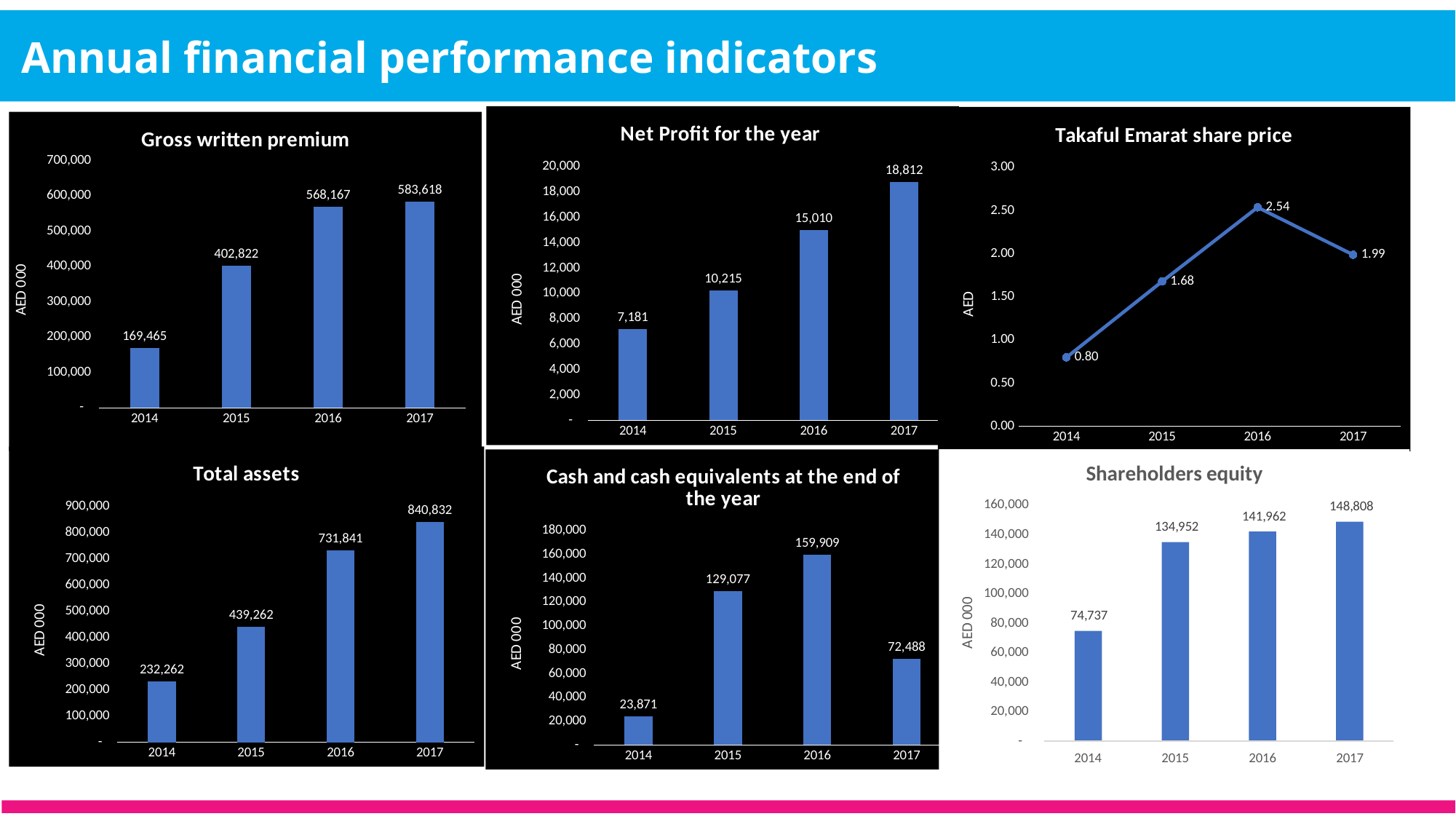
In the 'Net Profit for the year' chart, which year has the highest value? 2017 In the 'Shareholders equity' chart, how many years are plotted? 4 What is the y-axis label of the 'Total assets' chart? AED 000 In the 'Gross written premium' chart, what is the value for 2016? 568,167 In the 'Gross written premium' chart, do the values rise or fall from 2014 to 2017? Rise In the 'Shareholders equity' chart, what is the value for 2014? 74,737 In the 'Takaful Emarat share price' chart, what kind of chart is shown? Line chart In the 'Cash and cash equivalents at the end of the year' chart, which year has the lowest value? 2014 In the 'Total assets' chart, what is the difference between the 2017 and 2016 values? 108,991 In the 'Takaful Emarat share price' chart, what is the share price for 2015? 1.68 In the 'Net Profit for the year' chart, what is the difference between the 2015 and 2014 values? 3,034 In the 'Cash and cash equivalents at the end of the year' chart, is the value for 2016 larger than the value for 2017? Yes